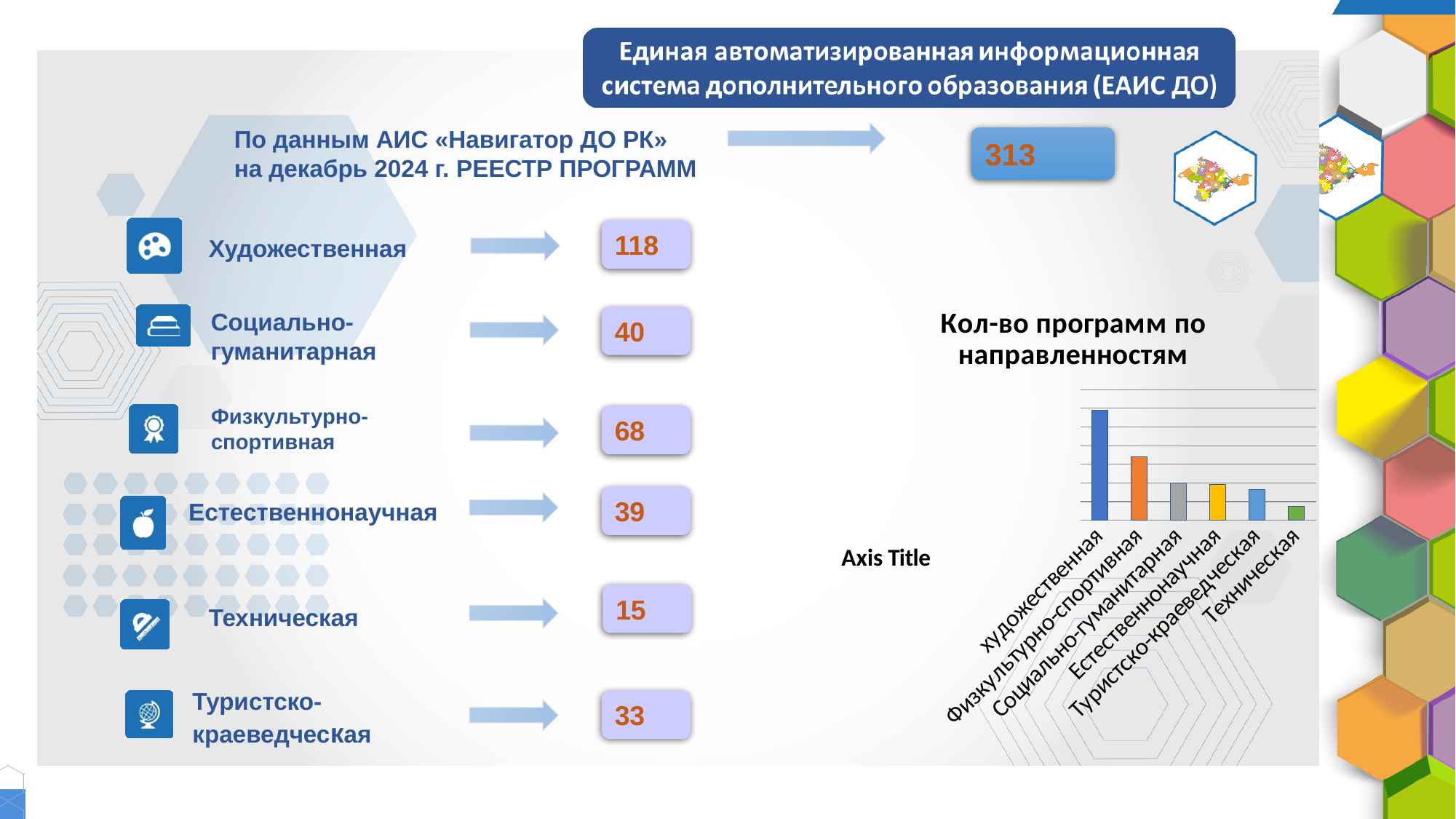
According to the slide, how many programs are in the Художественная category shown in the chart? 118 What kind of chart is shown under the title "Кол-во программ по направленностям"? bar chart In the chart "Кол-во программ по направленностям", which bar is taller: Туристско-краеведческая or Техническая? Туристско-краеведческая In the chart "Кол-во программ по направленностям", which category has the tallest bar? Художественная According to the slide, how many programs are in the Техническая category shown in the chart? 15 What is the title of the chart on the right side of the slide? Кол-во программ по направленностям According to the slide, how many programs are in the Физкультурно-спортивная category shown in the chart? 68 In the chart "Кол-во программ по направленностям", which bar is taller: Физкультурно-спортивная or Социально-гуманитарная? Физкультурно-спортивная How many categories are plotted in the chart "Кол-во программ по направленностям"? 6 Using the values printed on the slide, what is the difference between the Художественная and Техническая categories in the chart? 103 In the chart "Кол-во программ по направленностям", which category has the shortest bar? Техническая What placeholder text is shown as the axis title next to the chart "Кол-во программ по направленностям"? Axis Title